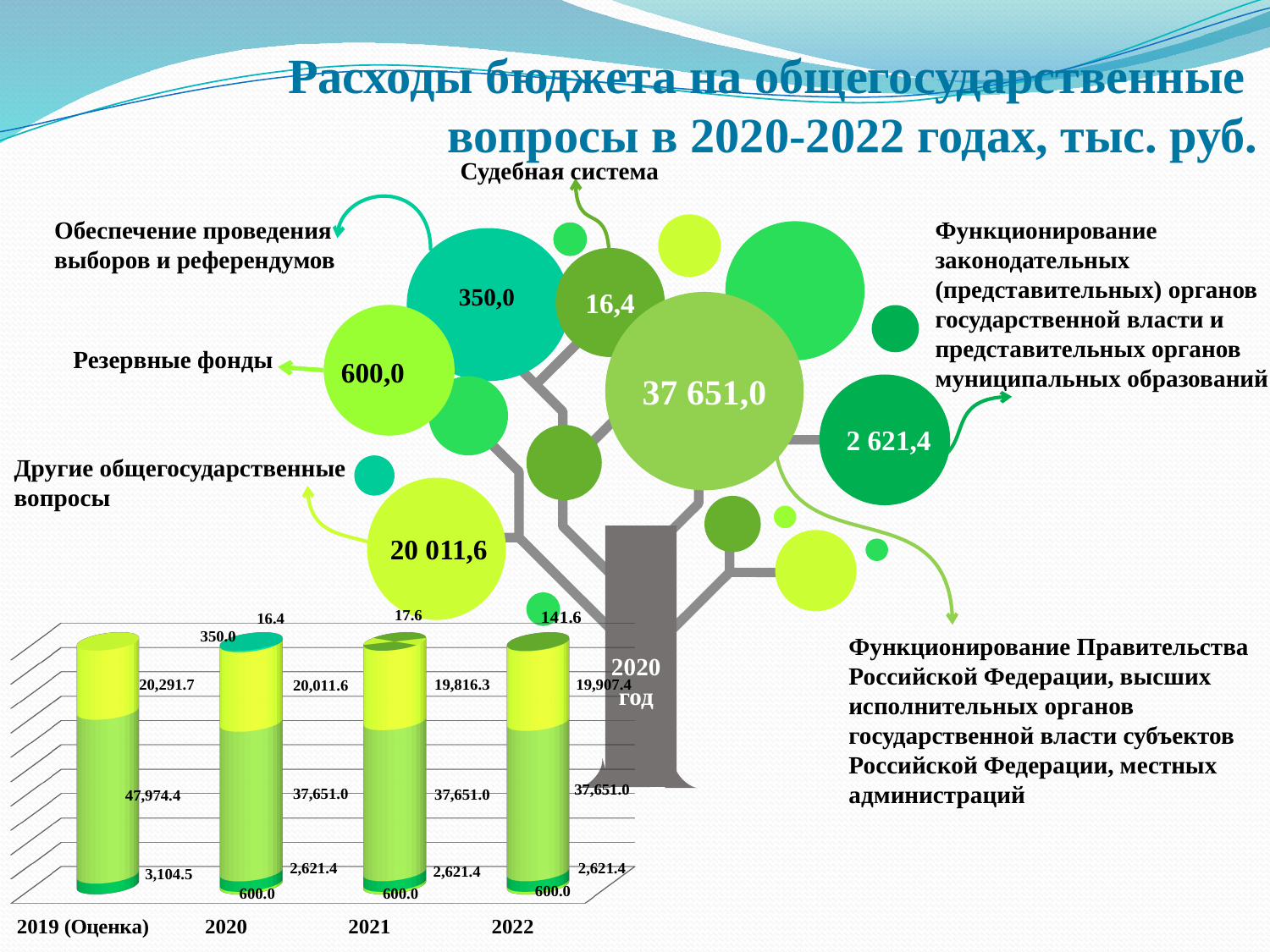
In the bar chart, what is the value of the small top segment for 2022? 141.6 What kind of chart is shown at the bottom left of the slide? bar chart In the bar chart, what is the difference between the 20,291.7 segment in 2019 (Оценка) and the 20,011.6 segment in 2020? 280.1 In the bar chart, which is larger: the 47,974.4 segment in 2019 (Оценка) or the 37,651.0 segment in 2020? 47,974.4 in 2019 (Оценка) In the bar chart, what is the difference between the bottom segment of 2019 (Оценка), 3,104.5, and the 2,621.4 segment of 2020? 483.1 How many years (categories) are shown on the x axis of the bar chart? 4 In the bar chart, what is the value of the bottom segment for 2019 (Оценка)? 3,104.5 In the tree diagram, what value is shown for Судебная система? 16,4 In the bar chart, what is the value of the segment labelled just below 37,651.0 for 2021? 2,621.4 In the bar chart, what is the value of the small top segment for 2021? 17.6 In the tree diagram, what value is shown for Резервные фонды? 600,0 In the bar chart, what is the largest labelled segment value for 2019 (Оценка)? 47,974.4